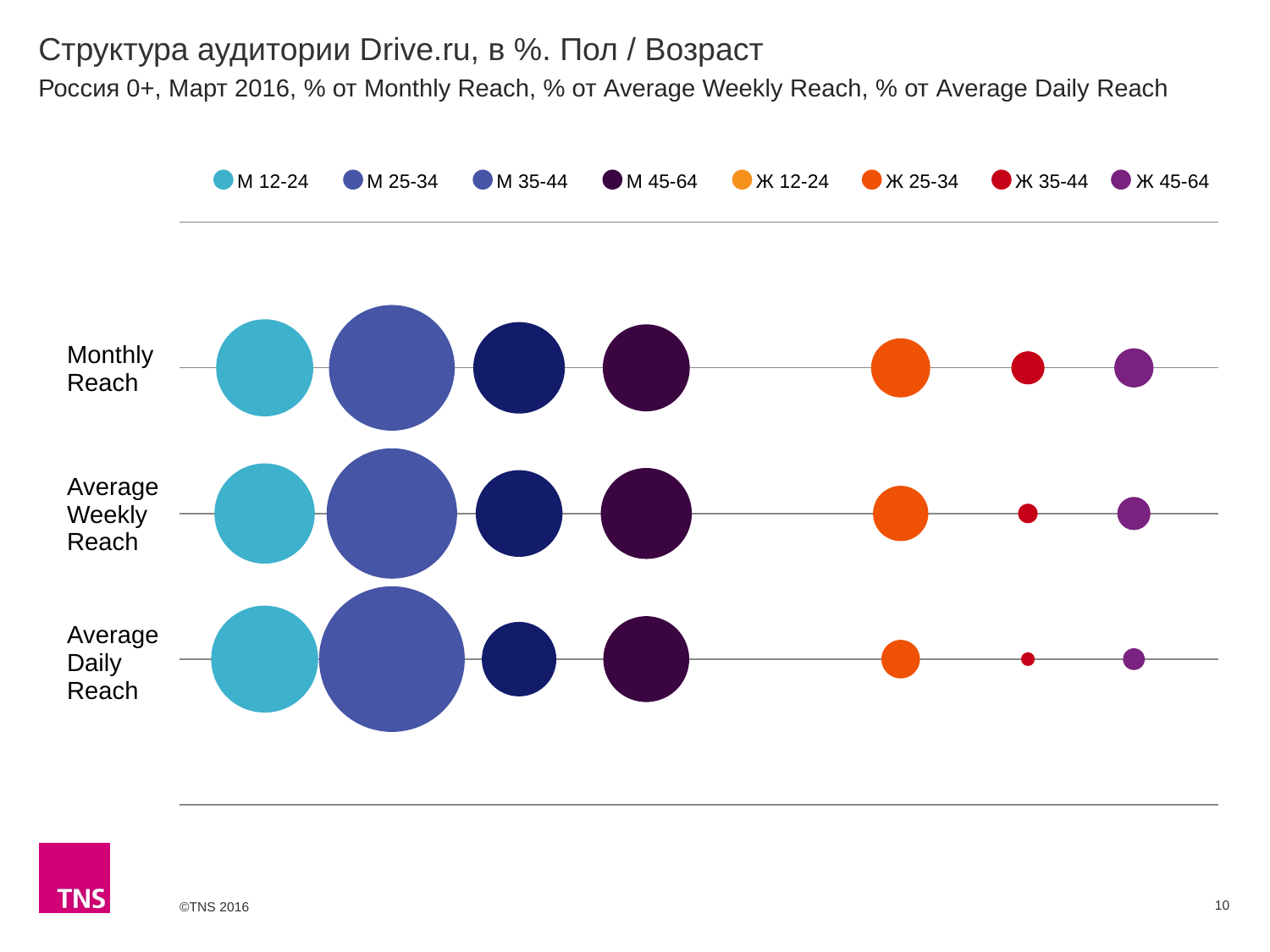
Does the Ж 35-44 bubble get larger or smaller going from Monthly Reach to Average Daily Reach? Smaller Which series has the largest bubble in the Monthly Reach row? М 25-34 How many reach categories (rows) are plotted on the chart? 3 In the Monthly Reach row, which bubble is larger: М 12-24 or Ж 25-34? М 12-24 Which series has the smallest visible bubble in the Average Daily Reach row? Ж 35-44 Does the М 25-34 bubble get larger or smaller going from Monthly Reach to Average Daily Reach? Larger Which series has the smallest visible bubble in the Average Weekly Reach row? Ж 35-44 Which series has the largest bubble in the Average Daily Reach row? М 25-34 What is the title of the chart on the slide? Структура аудитории Drive.ru, в %. Пол / Возраст What kind of chart is shown on the slide? Bubble chart How many series does the legend list? 8 In the Average Daily Reach row, which bubble is larger: М 45-64 or Ж 45-64? М 45-64